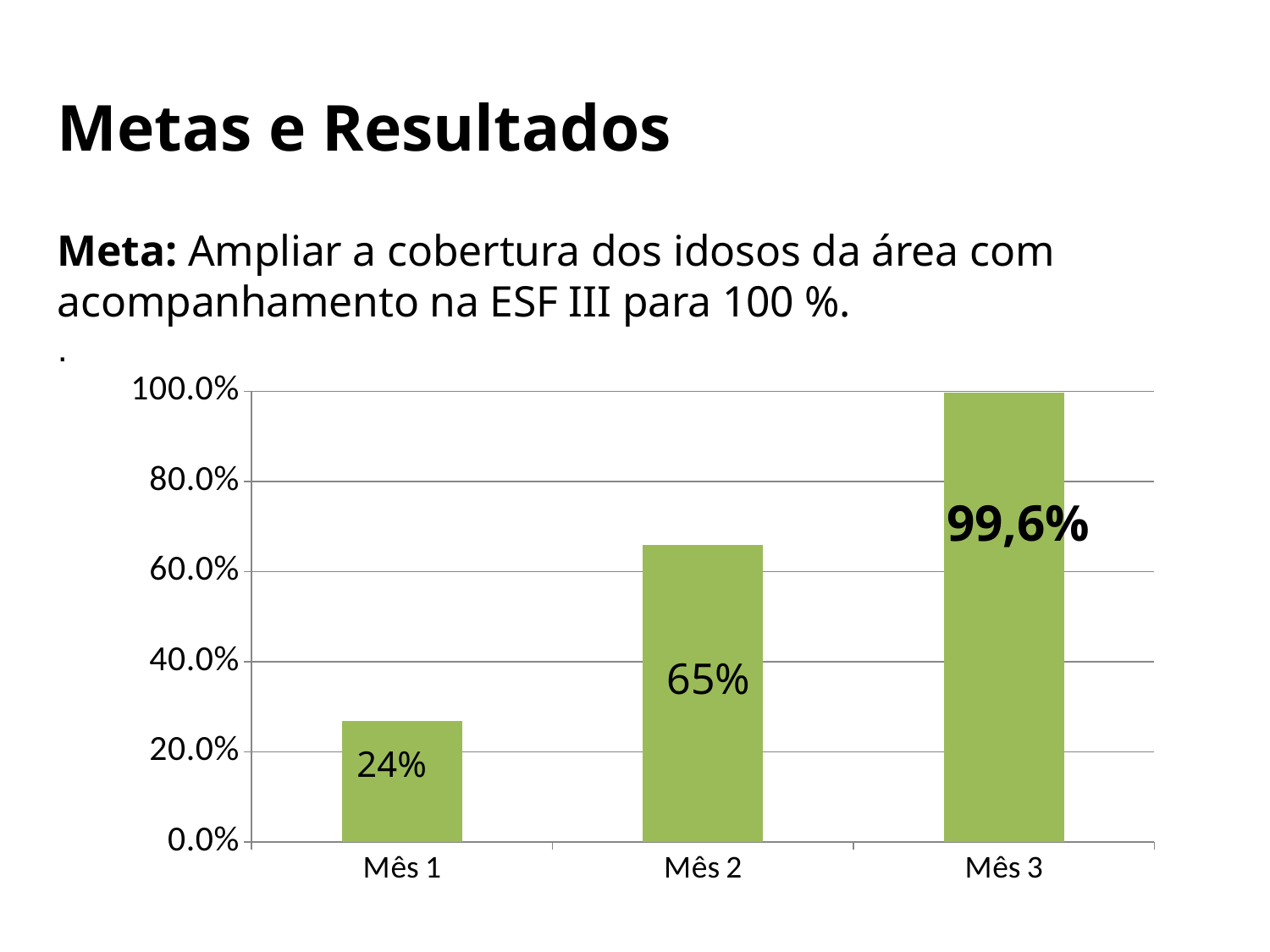
What is the value shown for Mês 1? 24% Is the value for Mês 3 greater or less than 80.0%? greater Which is larger, the value for Mês 2 or the value for Mês 1? Mês 2 Which month has the lowest value? Mês 1 Is the value for Mês 1 greater or less than 40.0%? less What kind of chart is shown on the slide? bar chart What is the value shown for Mês 3? 99,6% Which month has the highest value? Mês 3 What is the value shown for Mês 2? 65% Do the values rise or fall from Mês 1 to Mês 3? rise What is the difference between the values for Mês 2 and Mês 1? 41% How many categories are shown on the x axis? 3